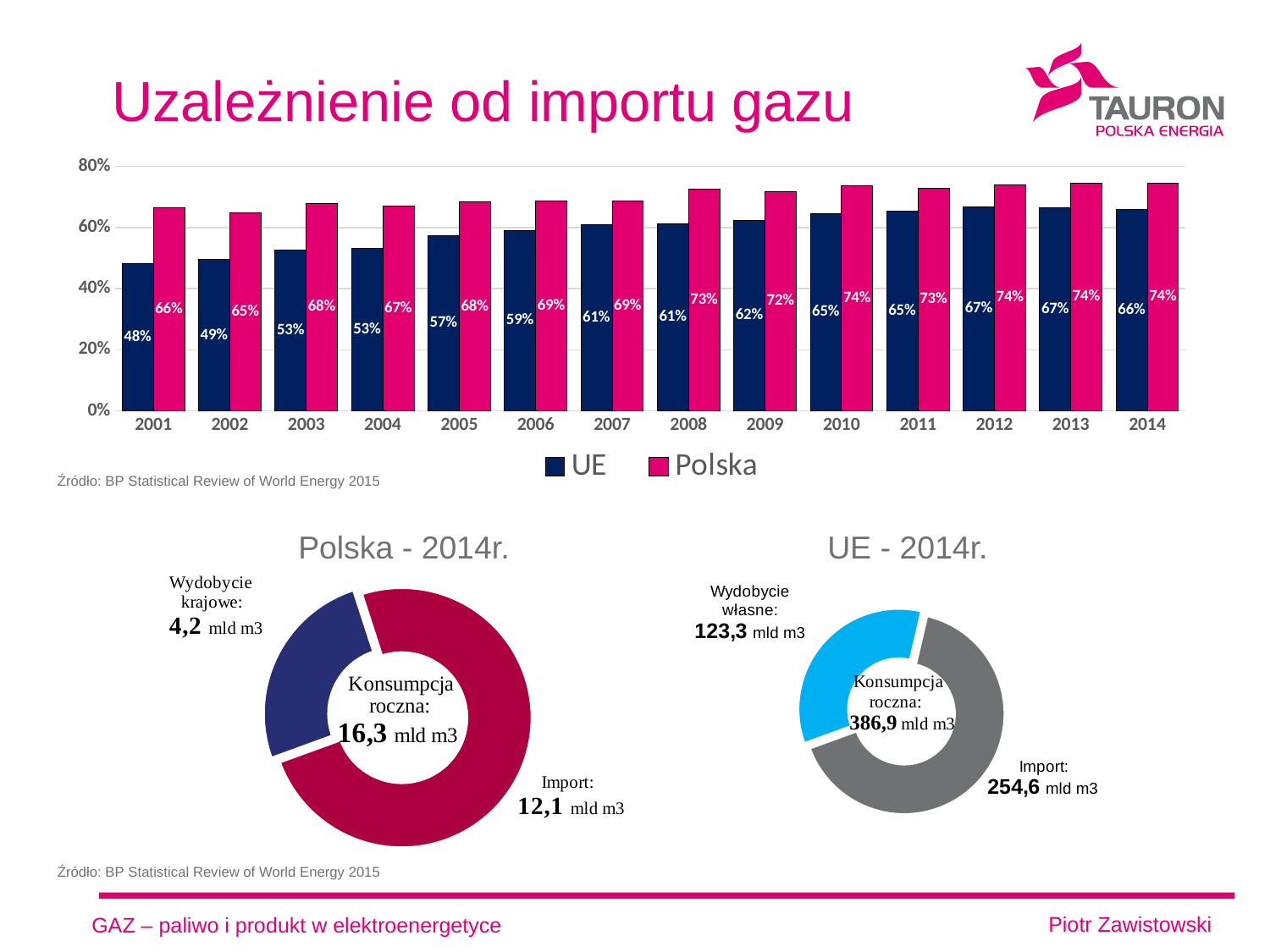
In the top bar chart, which year has the lowest value for UE? 2001 In the top bar chart, what is the value for UE in 2001? 48% What kind of chart is the 'UE - 2014r.' chart? donut (pie) chart In the top bar chart, which is larger in 2010: the UE value or the Polska value? Polska In the top bar chart, what is the value for Polska in 2008? 73% In the 'Polska - 2014r.' chart, what is the value for Import? 12,1 mld m3 In the top bar chart, how many years are shown on the x axis? 14 In the top bar chart, do the UE values generally rise or fall from 2001 to 2013? rise In the top bar chart, how many series does the legend list? 2 In the 'UE - 2014r.' chart, what is the value for Wydobycie własne? 123,3 mld m3 In the top bar chart, what is the value for UE in 2014? 66% In the top bar chart, what is the difference between the Polska and UE values in 2001? 18%